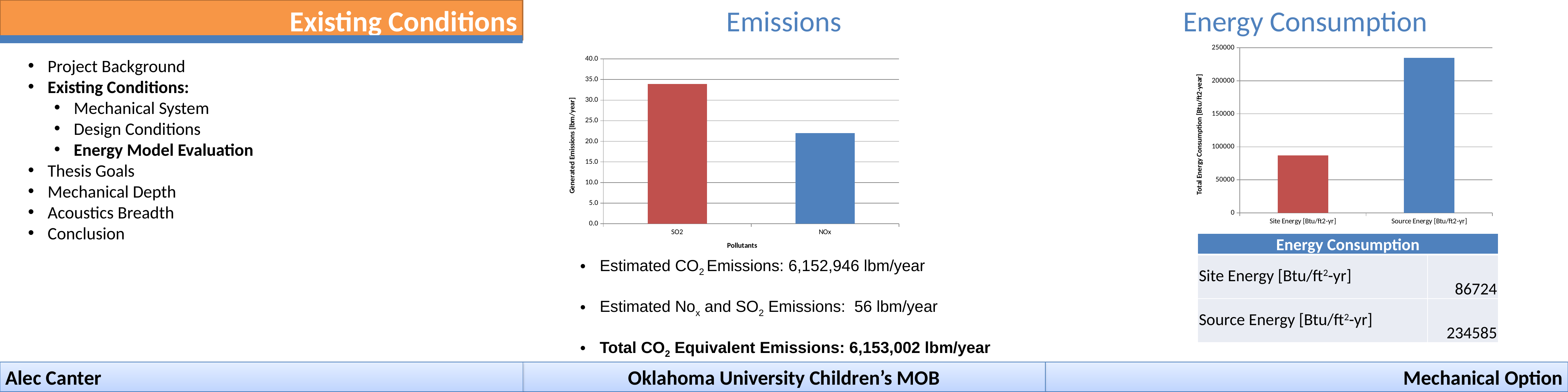
In the Energy Consumption chart, what is the value for Site Energy [Btu/ft2-yr]? 86724 What is the y-axis title of the Energy Consumption chart? Total Energy Consumption [Btu/ft2-year] In the Emissions chart, which pollutant has the higher generated emissions? SO2 What is the x-axis title of the Emissions chart? Pollutants How many pollutant categories are shown in the Emissions chart? 2 In the Energy Consumption chart, what is the value for Source Energy [Btu/ft2-yr]? 234585 In the Energy Consumption chart, what is the difference between Source Energy and Site Energy? 147861 In the Energy Consumption chart, is the value for Site Energy greater or less than 100000? less In the Emissions chart, is the value for SO2 greater or less than 30.0? greater In the Energy Consumption chart, which category has the higher value? Source Energy [Btu/ft2-yr] In the Emissions chart, is the value for NOx greater or less than 25.0? less What type of chart is the Emissions chart? bar chart